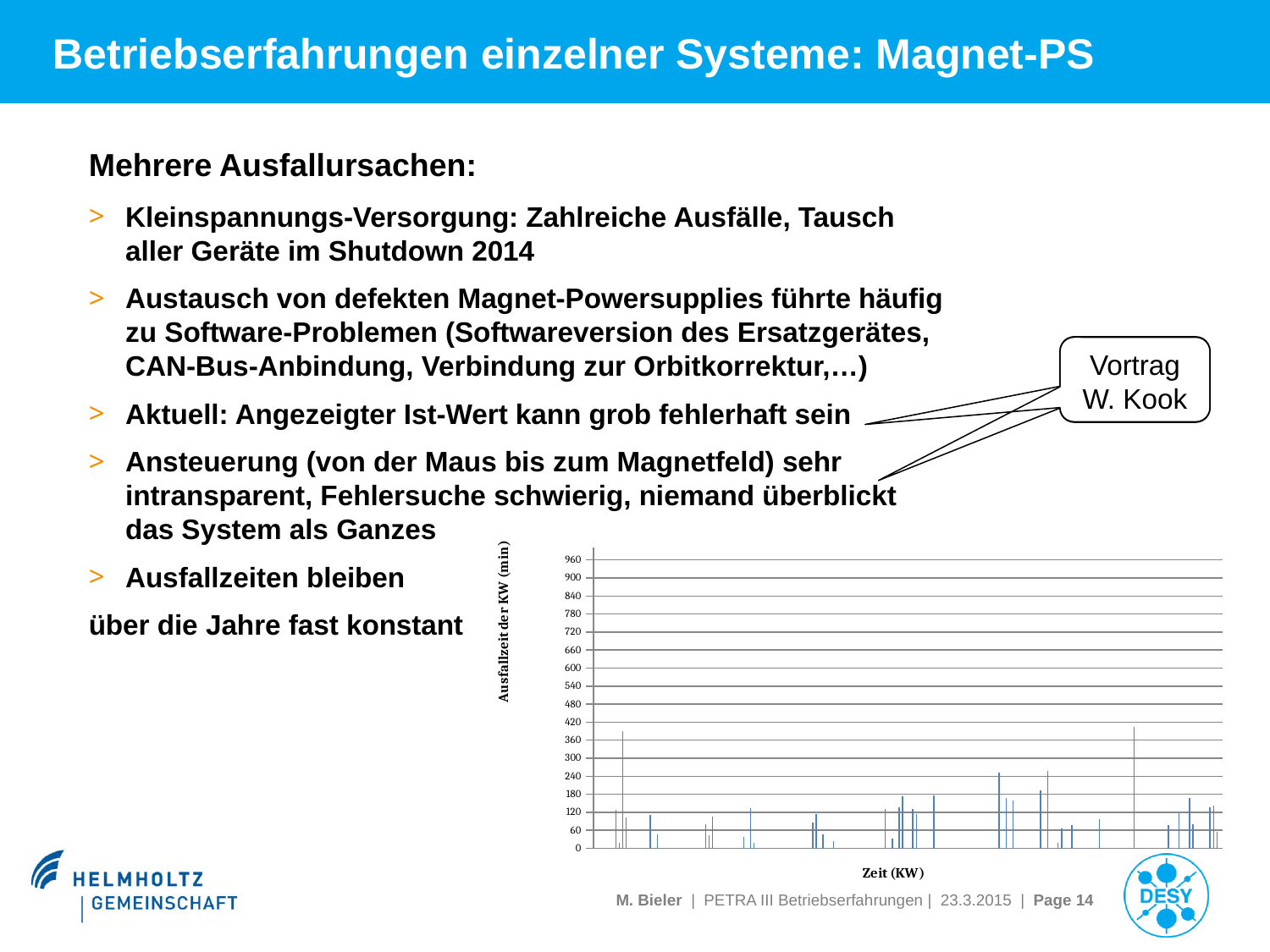
What is the spacing between consecutive tick marks on the vertical axis of the chart? 60 Is the tallest bar in the chart greater or less than 300? greater Is the tallest bar in the chart greater or less than 480? less What kind of chart is shown at the bottom right of the slide? bar chart What is the label of the horizontal axis of the chart? Zeit (KW) Does any bar in the chart reach a value greater than 600? No What is the highest value shown on the vertical axis of the chart? 960 What is the label of the vertical axis of the chart? Ausfallzeit der KW (min)